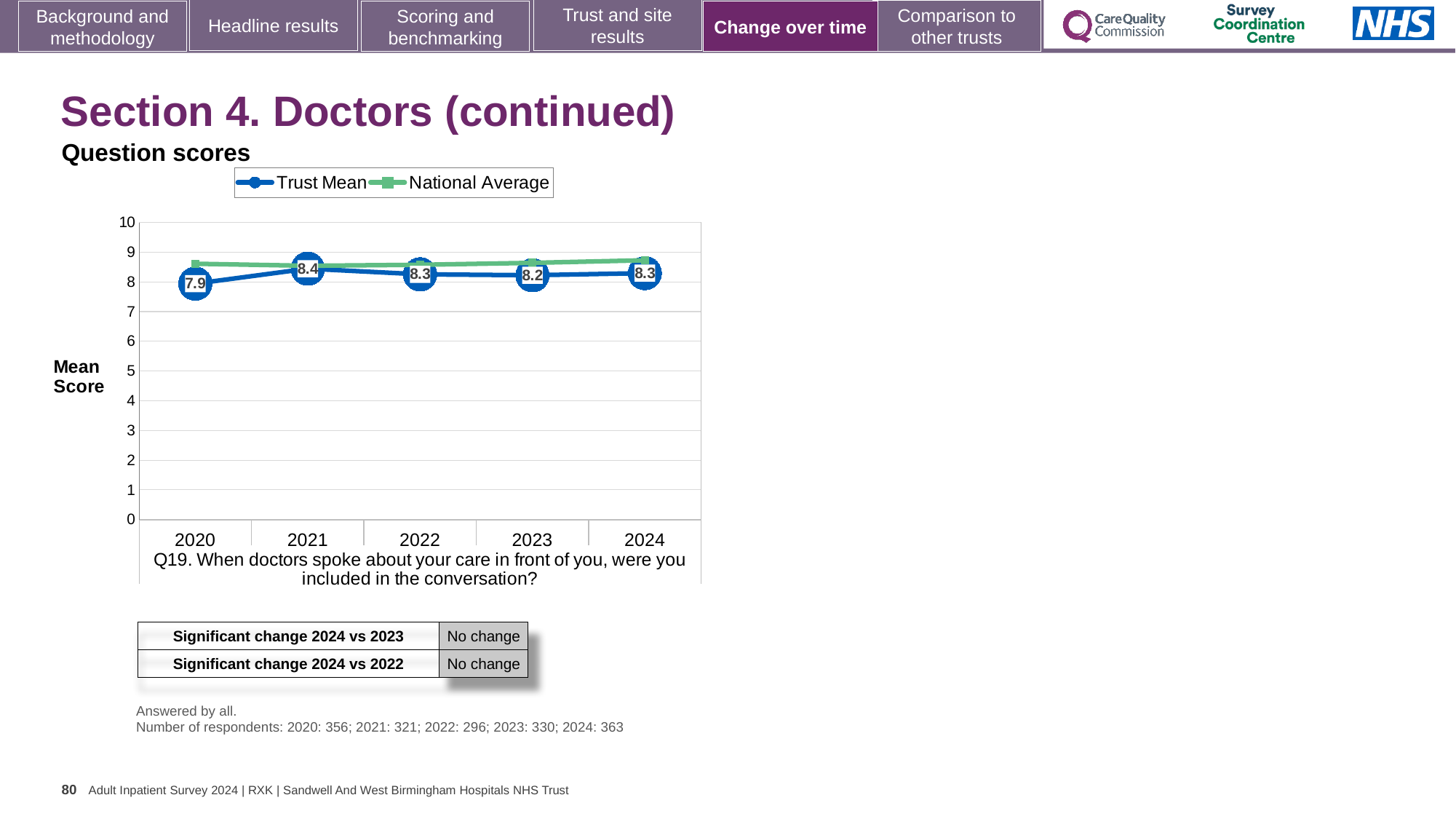
What is the Trust Mean score for 2020? 7.9 Which year has the larger Trust Mean score, 2020 or 2024? 2024 How many series does the legend list? 2 In which year is the Trust Mean score highest? 2021 In which year is the Trust Mean score lowest? 2020 Is the National Average value for 2020 greater or less than 8? greater What is the Trust Mean score for 2023? 8.2 How many years are plotted on the x axis? 5 What is the Trust Mean score for 2021? 8.4 What is the difference between the Trust Mean scores for 2021 and 2020? 0.5 Does the Trust Mean score rise or fall from 2020 to 2021? rise What kind of chart is shown on the slide? line chart